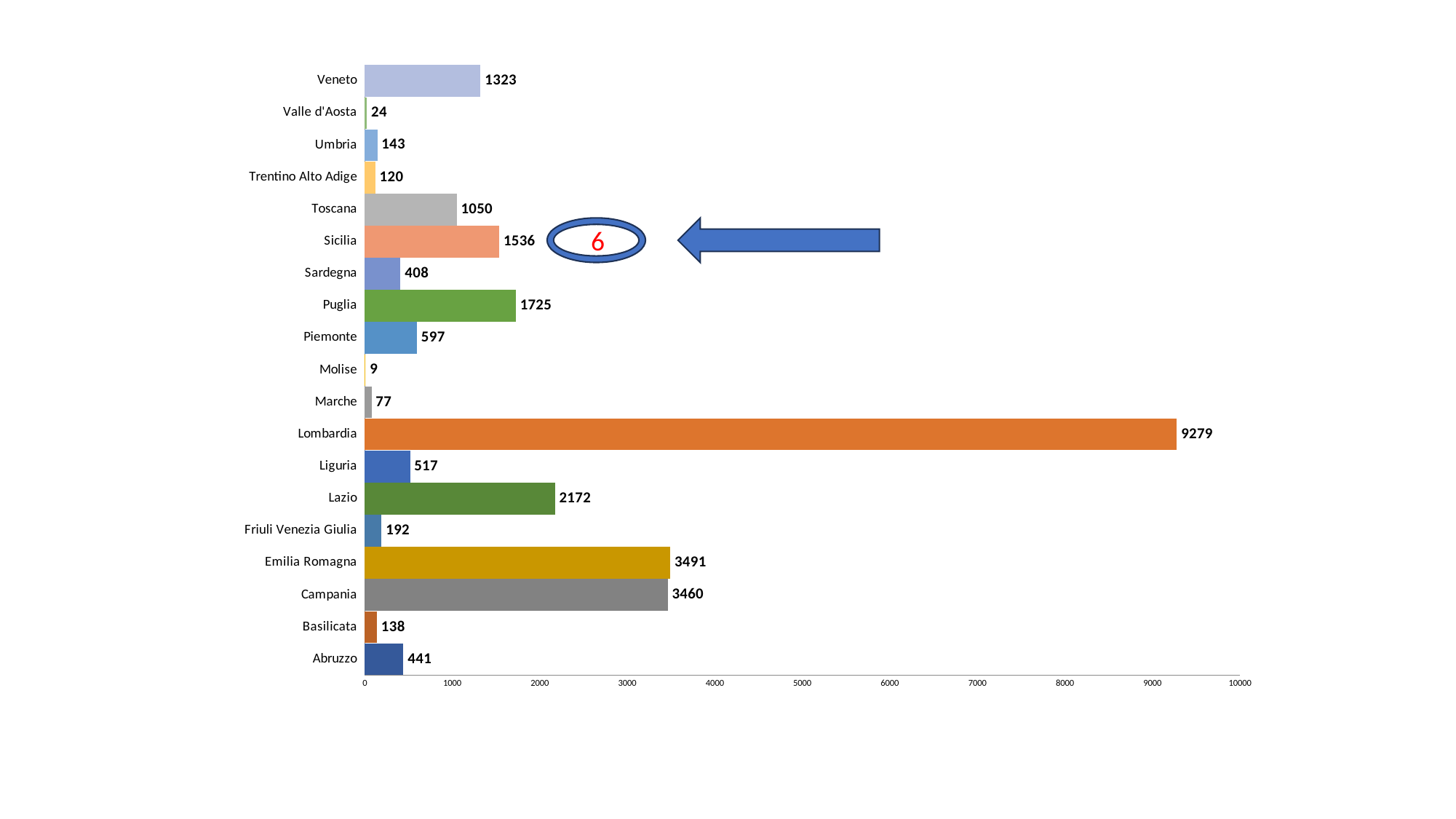
What is the value for Molise? 9 Which region has the highest value? Lombardia What is the value for Sicilia? 1536 What kind of chart is shown on the slide? Bar chart Is the value for Lombardia greater or less than 9000? greater What is the difference between the values for Emilia Romagna and Campania? 31 Which region has the lowest value? Molise What is the value for Emilia Romagna? 3491 How many regions are shown in the chart? 19 Which has a larger value, Piemonte or Liguria? Piemonte What is the difference between the values for Lazio and Puglia? 447 What is the value for Lombardia? 9279